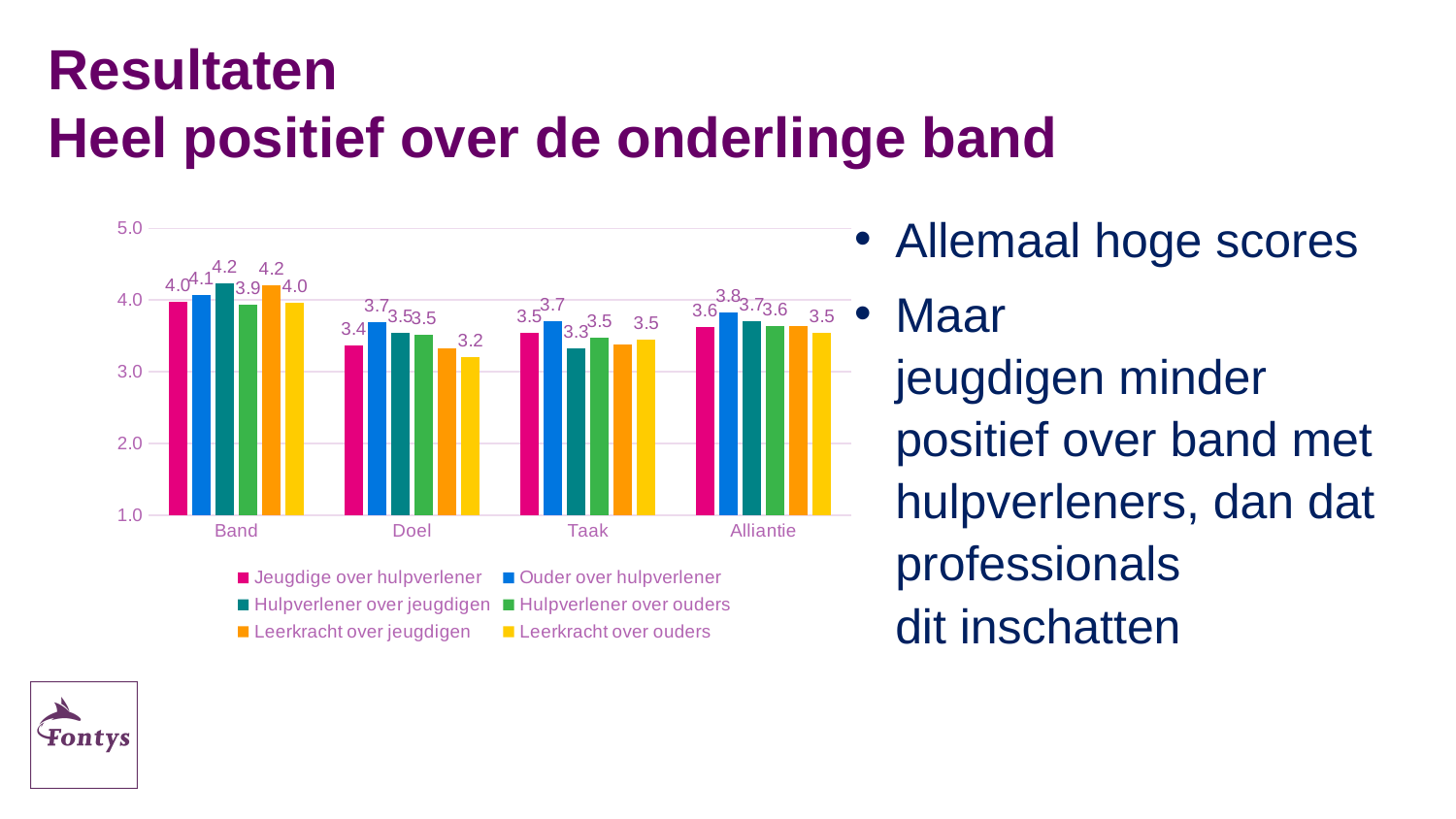
How many series does the chart legend list? 6 How many categories are shown on the x axis of the chart? 4 What is the difference between the 'Ouder over hulpverlener' values for Band and Doel? 0.4 What is the value for 'Ouder over hulpverlener' in the Alliantie category? 3.8 Which is larger: the 'Jeugdige over hulpverlener' value for Band or for Taak? Band What is the value for 'Hulpverlener over jeugdigen' in the Taak category? 3.3 In which category is the 'Jeugdige over hulpverlener' series lowest? Doel In which category is the 'Ouder over hulpverlener' series highest? Band What is the value for 'Jeugdige over hulpverlener' in the Band category? 4.0 What kind of chart is shown on the slide? bar chart What is the value for 'Leerkracht over ouders' in the Doel category? 3.2 Is the value for 'Leerkracht over jeugdigen' in the Doel category greater or less than 4.0? less